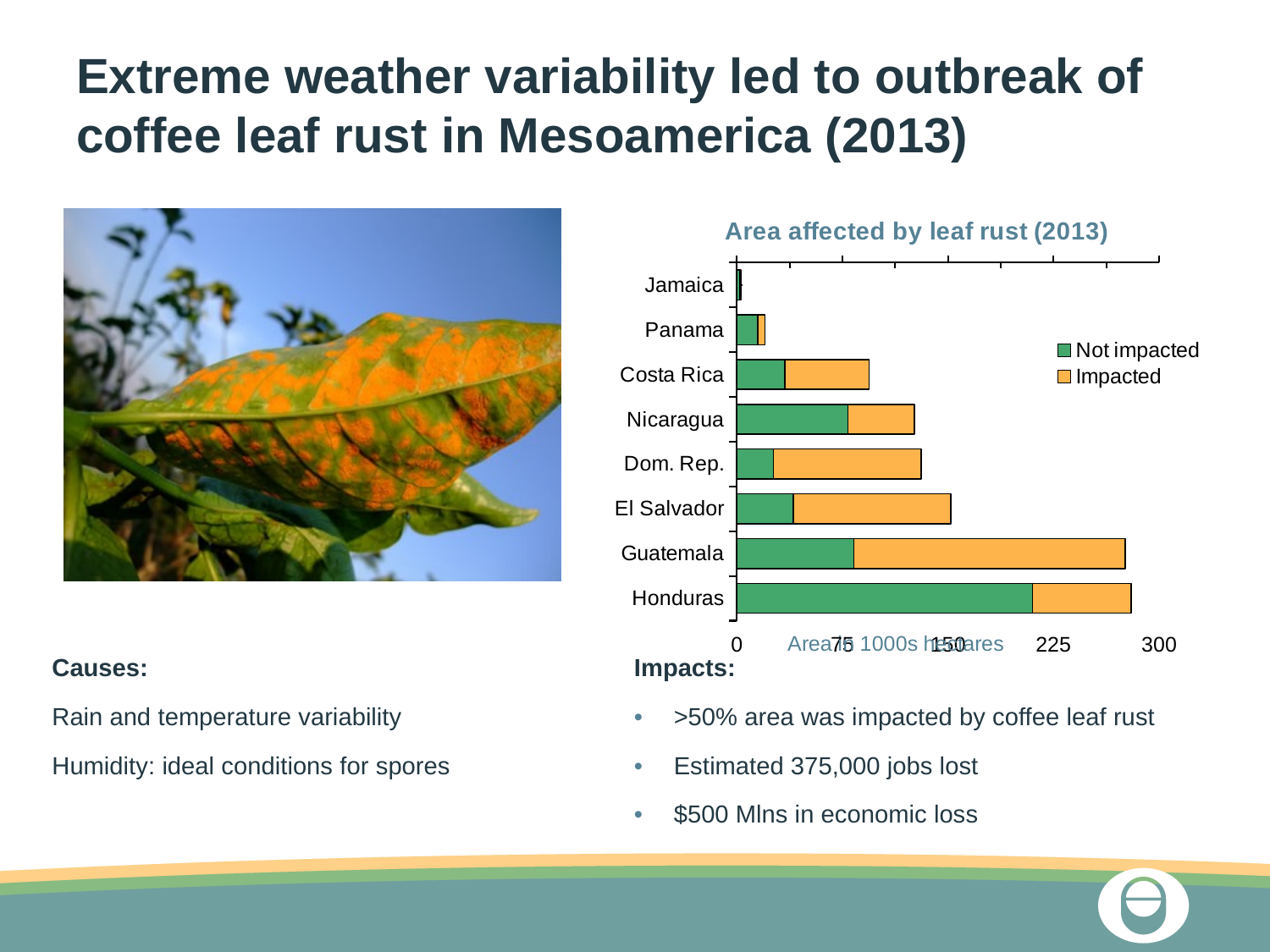
How many countries are shown in the chart? 8 Is the total bar for Jamaica greater or less than 75? less Which country has the largest impacted area segment? Guatemala Which country has a larger not impacted area, Honduras or Guatemala? Honduras Which country has the smallest total area in the chart? Jamaica Is the total bar for Nicaragua greater or less than 150? less What kind of chart is shown on the slide? Stacked bar chart Is the total bar for Honduras greater or less than 225? greater How many series does the chart legend list? 2 What is the title of the chart? Area affected by leaf rust (2013) Which has a larger total bar, Guatemala or Costa Rica? Guatemala